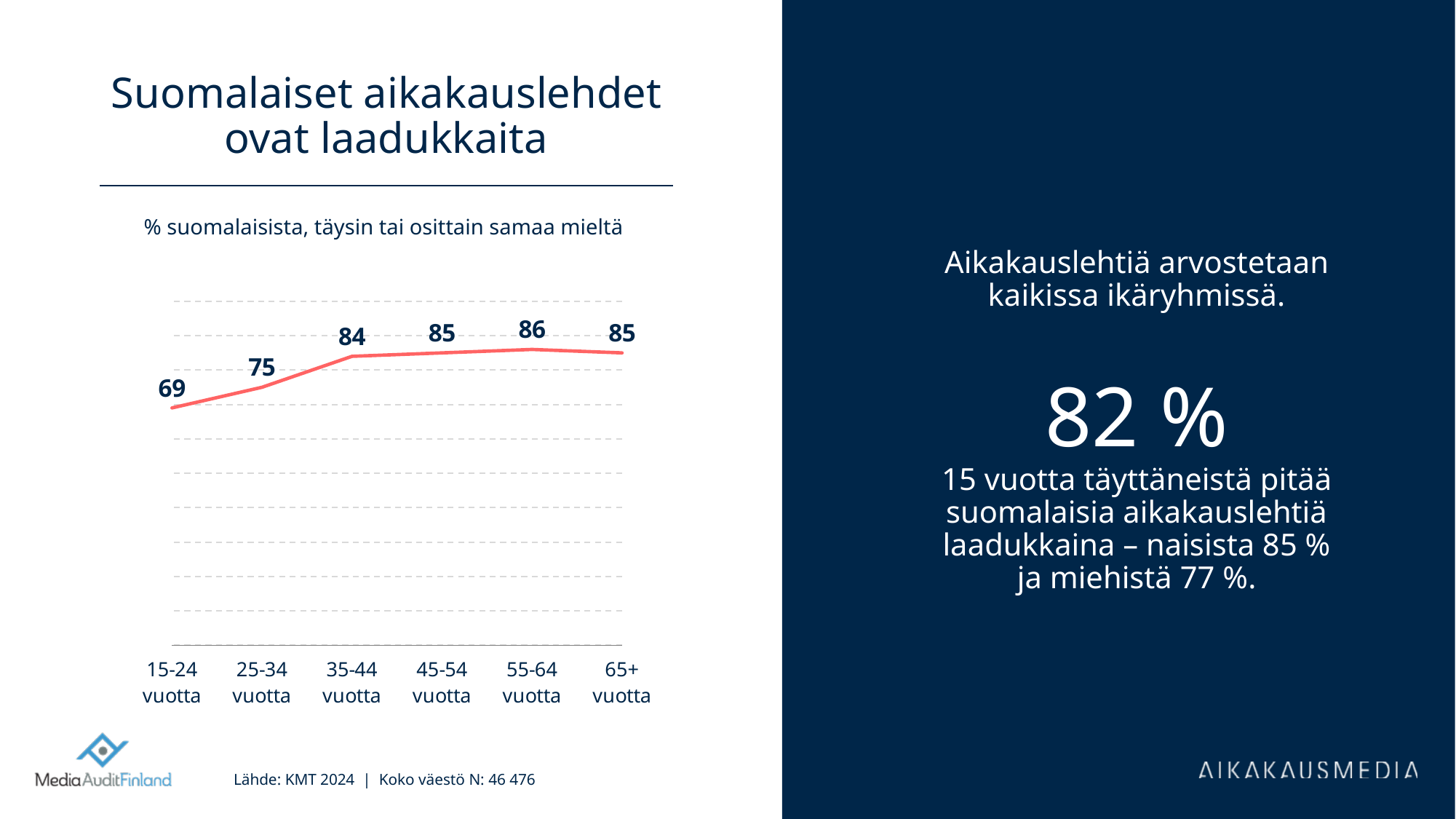
What is the value for the 45-54 vuotta age group? 85 Which age group has the highest value? 55-64 vuotta Which is larger, the value for 25-34 vuotta or the value for 35-44 vuotta? 35-44 vuotta What is the value for the 15-24 vuotta age group? 69 How many age groups are plotted on the chart? 6 What is the subtitle text shown above the chart? % suomalaisista, täysin tai osittain samaa mieltä Which age group has the lowest value? 15-24 vuotta What is the difference between the values for 55-64 vuotta and 15-24 vuotta? 17 What is the difference between the values for 25-34 vuotta and 15-24 vuotta? 6 What is the value for the 35-44 vuotta age group? 84 What kind of chart is shown on the slide? line chart Do the values generally rise or fall from the youngest to the oldest age group? rise